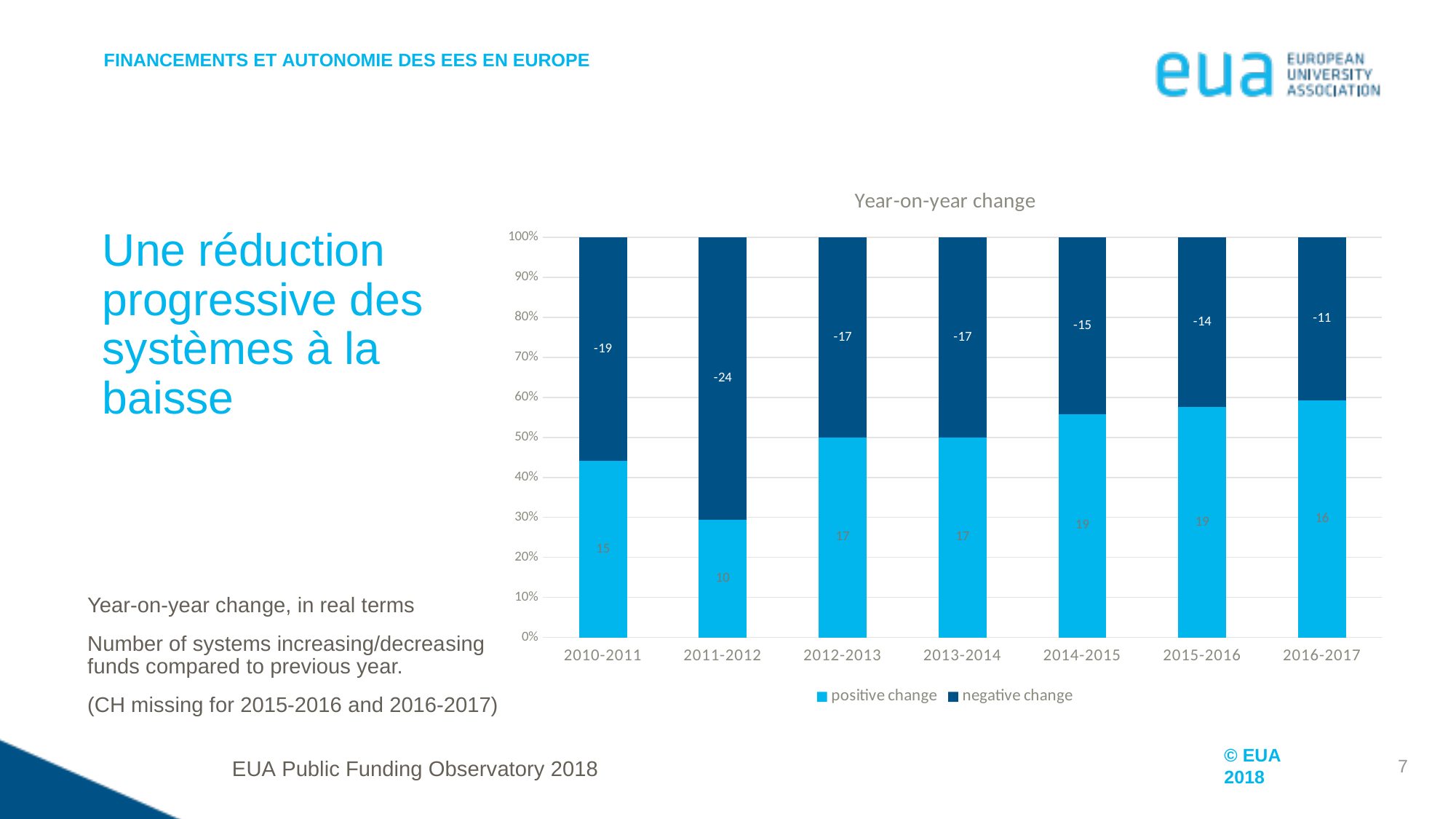
Is the positive change share for 2016-2017 greater or less than 50%? greater What is the data label for negative change in 2016-2017? -11 What is the data label for positive change in 2011-2012? 10 How many series does the legend list? 2 Which period has the smallest negative change label in absolute terms? 2016-2017 What is the title of the chart? Year-on-year change Which period has the lowest positive change label? 2011-2012 What is the data label for negative change in 2011-2012? -24 Is the positive change share for 2010-2011 greater or less than 50%? less What kind of chart is shown? Stacked bar chart What is the data label for positive change in 2014-2015? 19 How many periods are shown on the x axis? 7